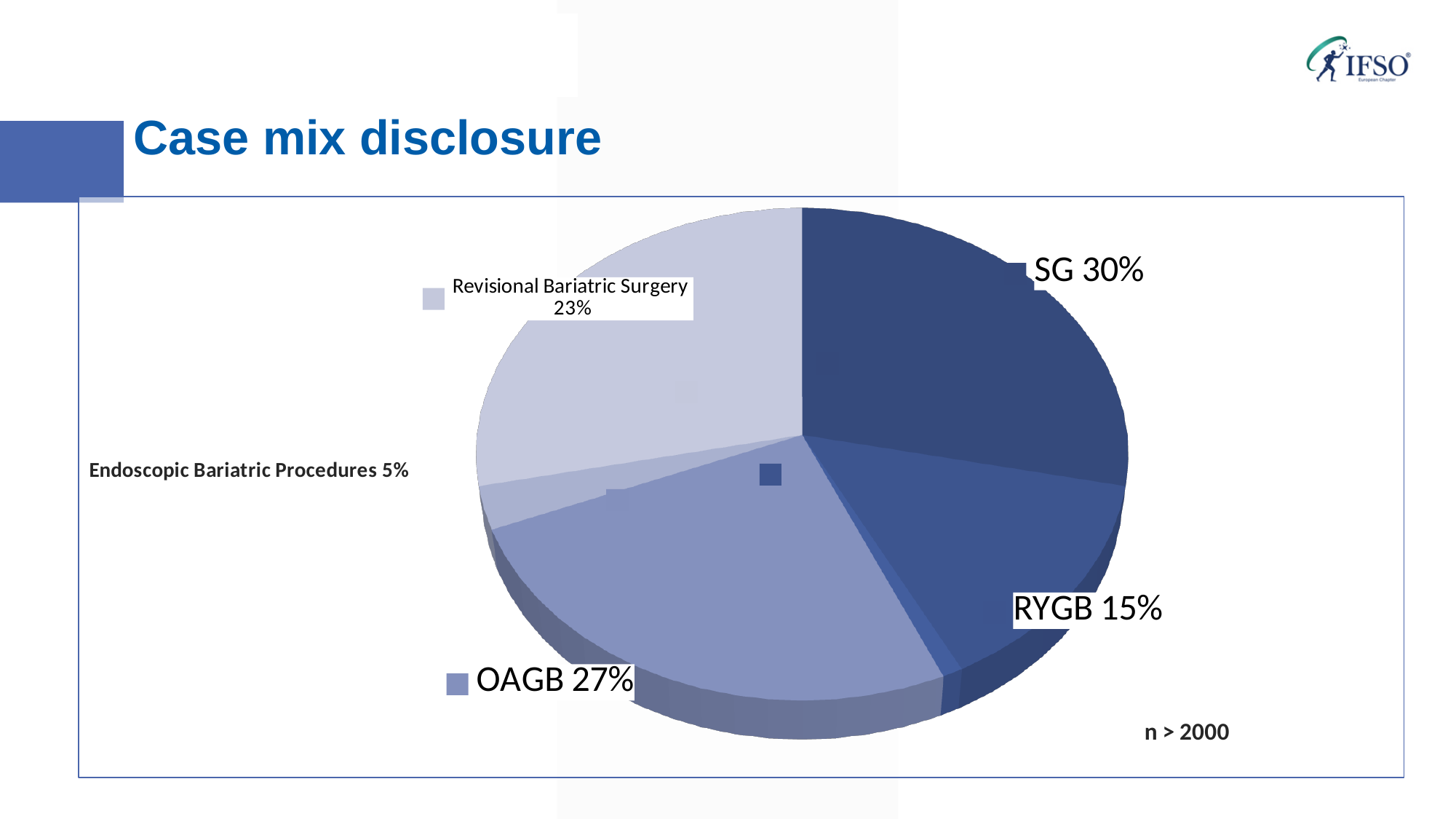
What is the difference in percentage points between SG and RYGB? 15 What kind of chart is shown on the slide? Pie chart What share of the pie do Endoscopic Bariatric Procedures represent? 5% What share of the pie does RYGB represent? 15% Which category has the smallest slice of the pie? Endoscopic Bariatric Procedures Which category has the largest slice of the pie? SG What share of the pie does Revisional Bariatric Surgery represent? 23% What share of the pie does OAGB represent? 27% What is the title of the slide containing the chart? Case mix disclosure What share of the pie does SG represent? 30% Which is larger, the OAGB slice or the Revisional Bariatric Surgery slice? OAGB